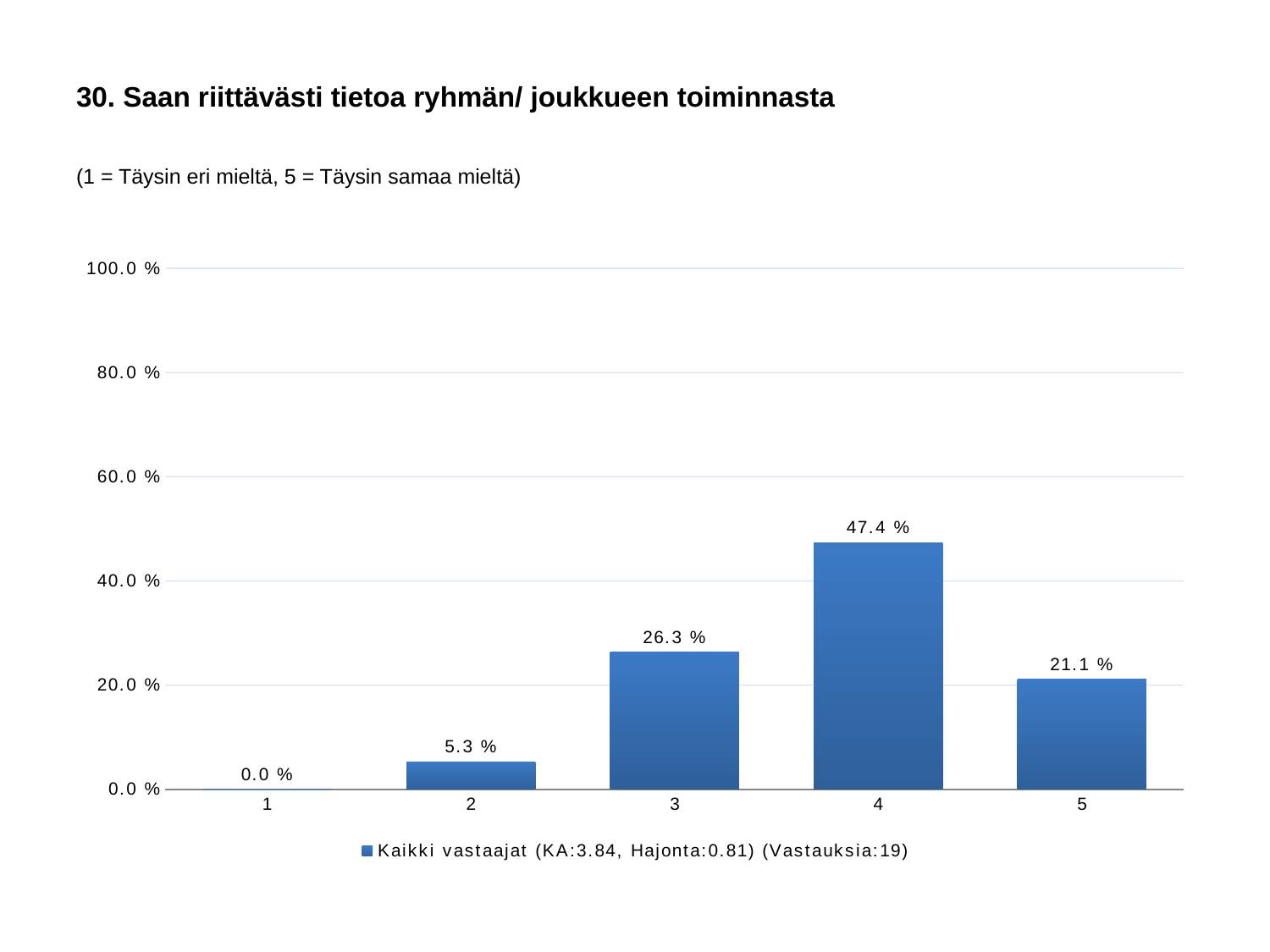
How many categories are shown on the x axis? 5 How many series does the legend list? 1 What is the value for category 2? 5.3 % What is the value for category 4? 47.4 % What is the value for category 5? 21.1 % What is the number of responses (Vastauksia) given in the legend? 19 Is the value for category 4 greater or less than 40.0 %? greater Which is larger, the value for category 3 or the value for category 5? 3 What is the difference between the values for categories 4 and 3? 21.1 % What kind of chart is shown? bar chart Which category has the highest value? 4 Which category has the lowest value? 1